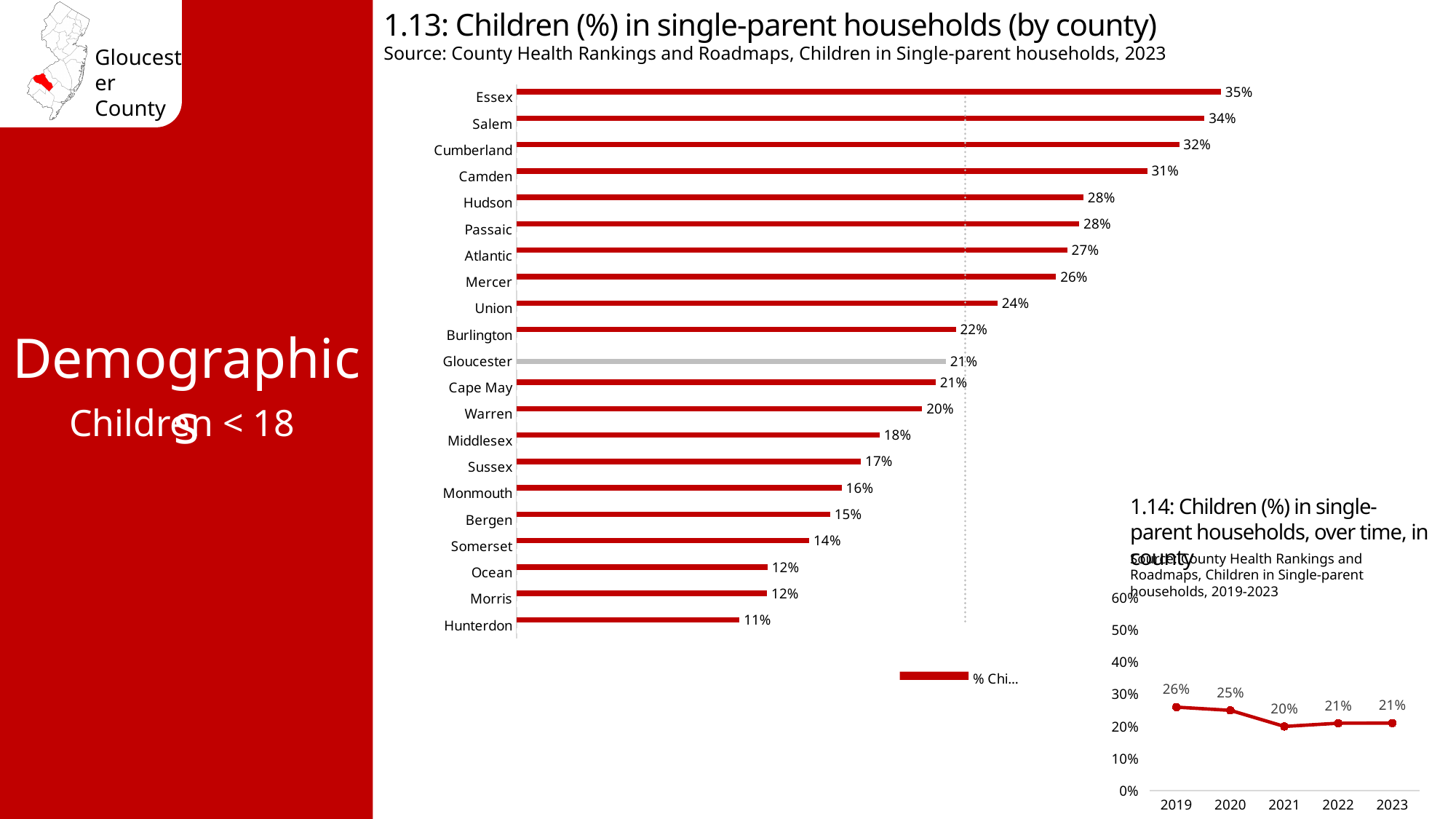
In chart 1.14, how many years are plotted? 5 In chart 1.14, which year has the lowest value? 2021 In chart 1.13, which county has the lowest percentage of children in single-parent households? Hunterdon In chart 1.14 (Children (%) in single-parent households over time), what is the value for 2019? 26% In chart 1.14, do the values generally rise or fall from 2019 to 2023? Fall In chart 1.13, which has a higher value, Salem or Cumberland? Salem What kind of chart is chart 1.13? Bar chart In chart 1.13 (Children (%) in single-parent households by county), what is the value for Gloucester? 21% In chart 1.13, how many counties are shown? 21 In chart 1.13, which county has the highest percentage of children in single-parent households? Essex In chart 1.13, what is the value for Camden? 31% In chart 1.13, what is the difference between the values for Essex and Hunterdon? 24%